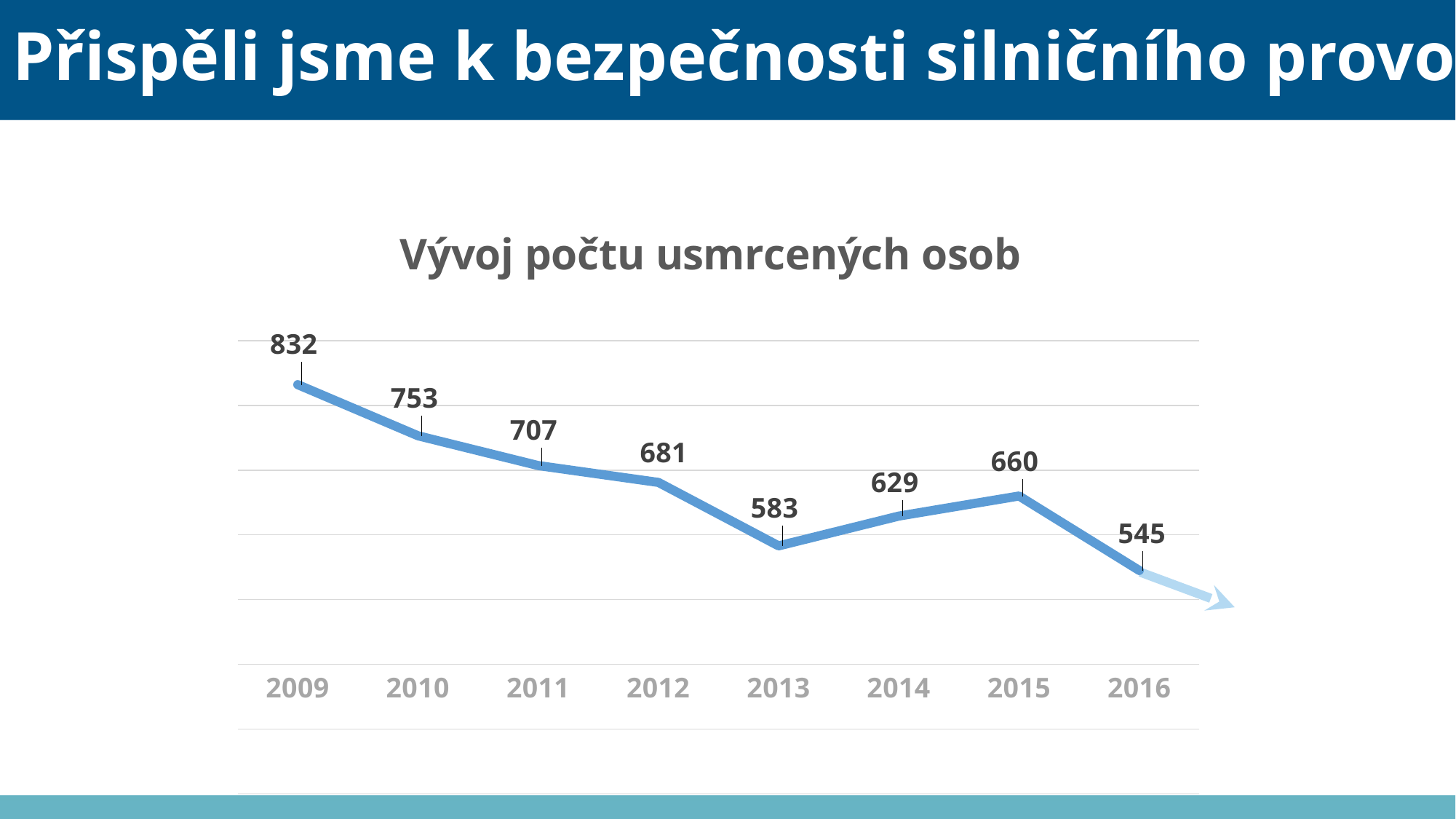
What kind of chart is shown? line chart Which year has the highest value? 2009 What is the value for 2016? 545 Which is larger, the value for 2013 or the value for 2015? 2015 What is the value for 2009? 832 What is the difference between the values for 2015 and 2014? 31 How many years are plotted on the chart? 8 What is the difference between the values for 2009 and 2016? 287 What is the title of the chart? Vývoj počtu usmrcených osob Do the values generally rise or fall from 2009 to 2016? fall Which year has the lowest value? 2016 What is the value for 2013? 583